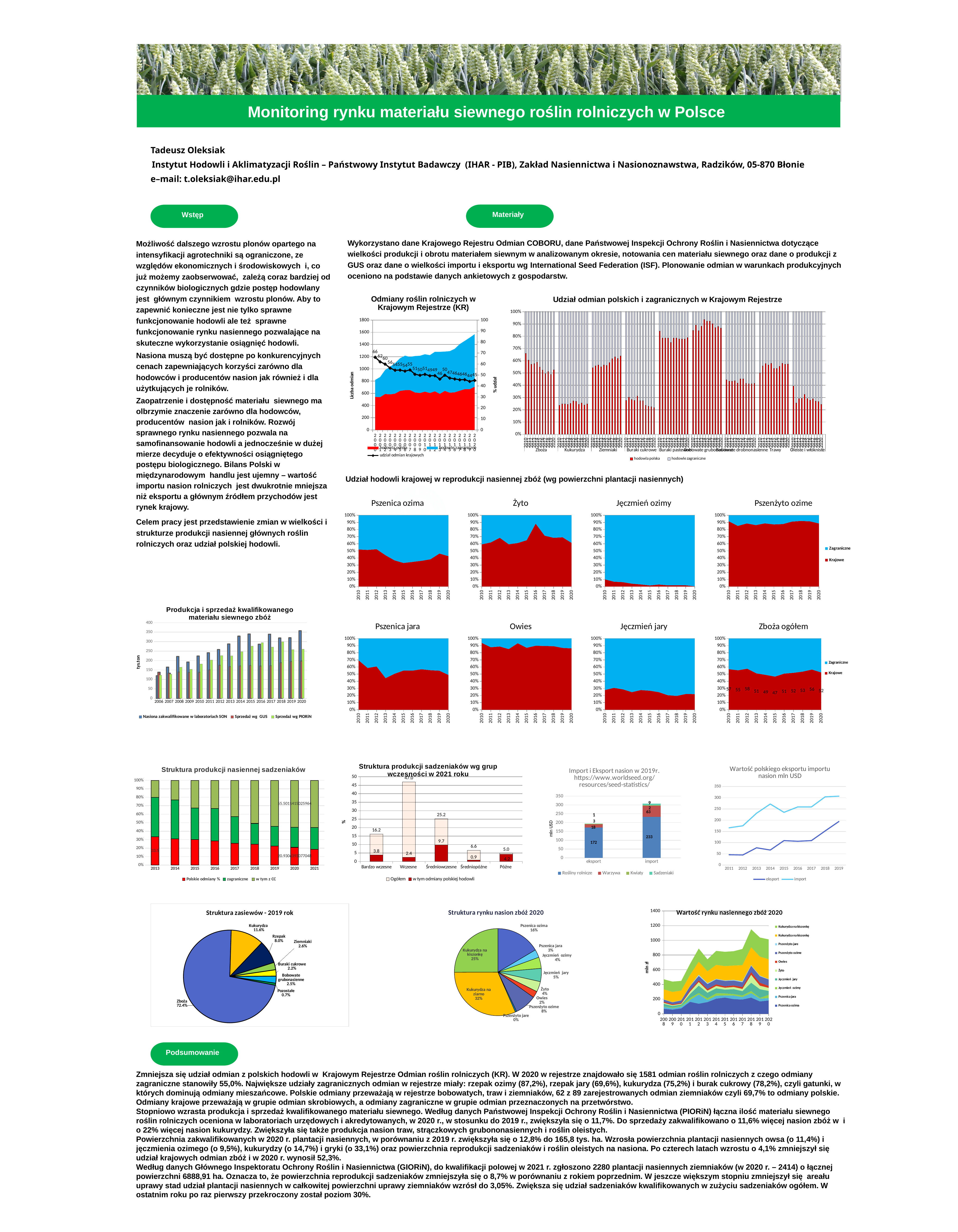
In the chart 'Struktura rynku nasion zbóż 2020', which category has the largest share? Kukurydza na ziarno How many series does the legend of the chart 'Import i Eksport nasion w 2019r.' list? 4 In the chart 'Import i Eksport nasion w 2019r.', what is the difference between the Rośliny rolnicze values for import (233) and eksport (172)? 61 What kind of chart is 'Struktura zasiewów - 2019 rok'? pie chart In the line chart 'Wartość polskiego eksportu importu nasion mln USD', which line is higher in 2019, eksport or import? import In the chart 'Struktura produkcji sadzeniaków wg grup wczesności w 2021 roku', what is the Ogółem value for Wczesne? 47.0 In the pie chart 'Struktura zasiewów - 2019 rok', what share is shown for Zboża? 72.4% How many categories are shown on the x axis of the chart 'Struktura produkcji sadzeniaków wg grup wczesności w 2021 roku'? 5 In the pie chart 'Struktura zasiewów - 2019 rok', which category has the smallest share? Pozostałe In the chart 'Struktura rynku nasion zbóż 2020', what share is shown for Kukurydza na ziarno? 32% In the chart 'Import i Eksport nasion w 2019r.', what is the value for Rośliny rolnicze in the import bar? 233 How many series does the legend of the chart 'Produkcja i sprzedaż kwalifikowanego materiału siewnego zbóż' list? 3